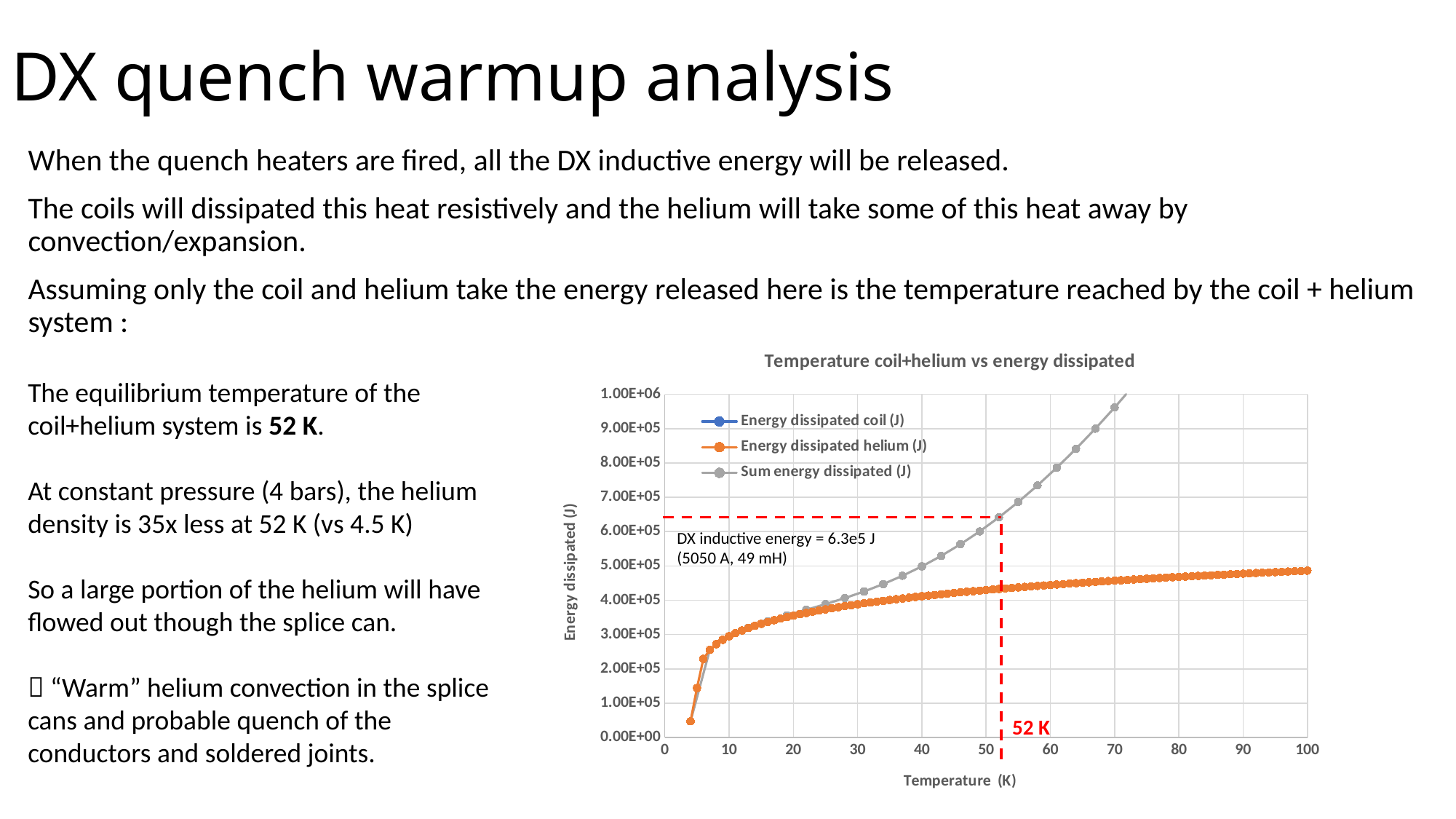
How many series does the chart legend list? 3 What value of DX inductive energy is annotated on the chart? 6.3e5 J Is the value of Sum energy dissipated (J) at 60 K greater or less than 7.00E+05? greater Does the Energy dissipated helium (J) series rise or fall as temperature increases? rise Does the Sum energy dissipated (J) series rise or fall as temperature increases? rise At 40 K, which series has the larger value: Sum energy dissipated (J) or Energy dissipated helium (J)? Sum energy dissipated (J) What kind of chart is shown on the slide? line chart What temperature is marked by the red dashed vertical line on the chart? 52 K Is the value of Sum energy dissipated (J) at 70 K greater or less than 9.00E+05? greater Is the value of Energy dissipated helium (J) at 100 K greater or less than 5.00E+05? less What is the title of the chart? Temperature coil+helium vs energy dissipated